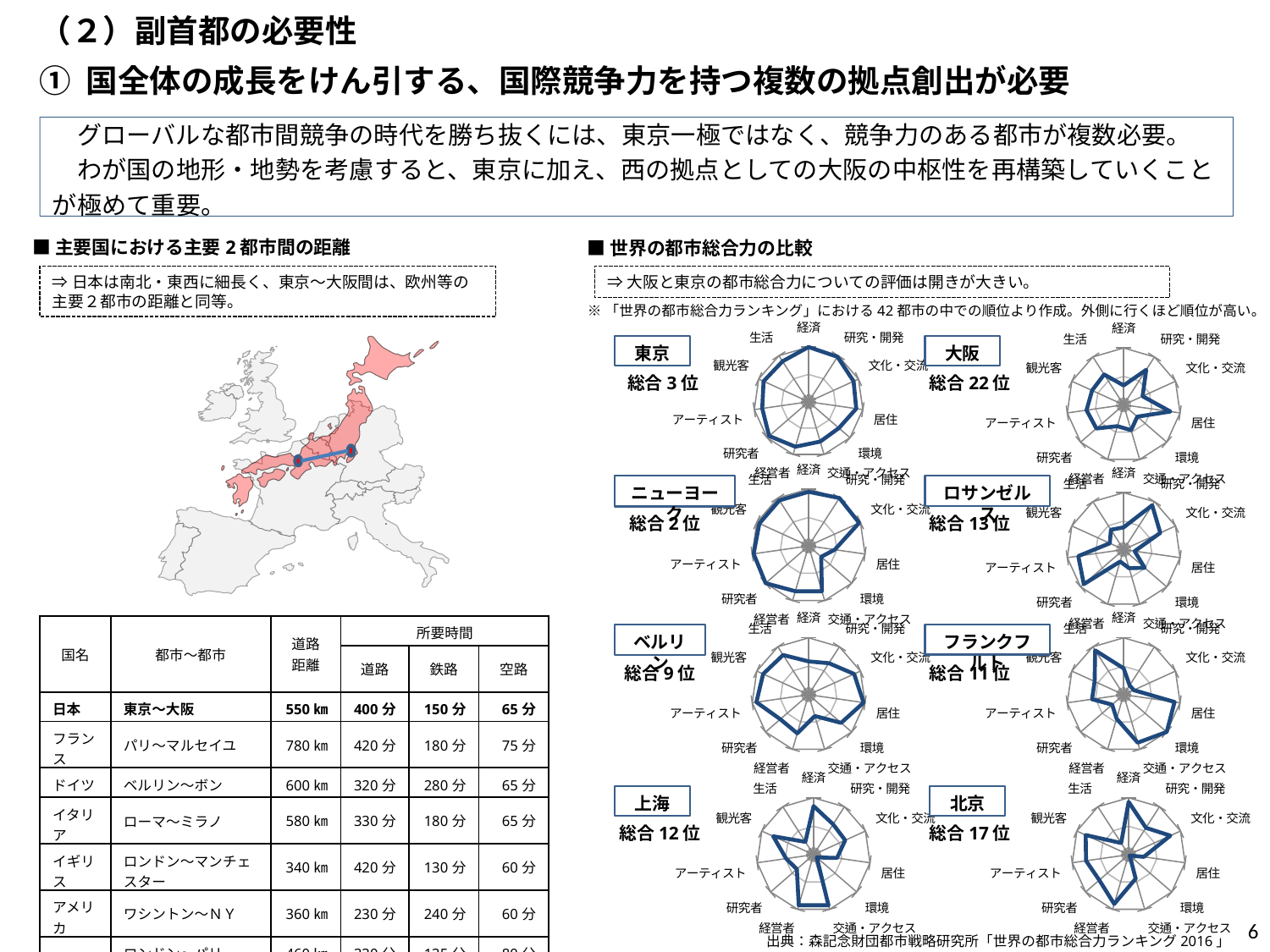
In the 「世界の都市総合力の比較」 section, what overall rank (総合) is shown for 上海? 総合12位 What source is cited for the radar charts in the 「世界の都市総合力の比較」 section? 森記念財団都市戦略研究所「世界の都市総合力ランキング 2016」 Comparing the radar charts for 東京 and 大阪, which city's plotted shape extends further toward the outer edge overall? 東京 In the 「世界の都市総合力の比較」 section, what overall rank (総合) is shown for 東京? 総合3位 Among the eight cities in the 「世界の都市総合力の比較」 section, which has the worst (lowest) overall rank? 大阪 What type of chart is used in the 「世界の都市総合力の比較」 section to show each city's profile? Radar chart In the 「世界の都市総合力の比較」 section, what overall rank (総合) is shown for ベルリン? 総合9位 In the 「世界の都市総合力の比較」 section, what overall rank (総合) is shown for 大阪? 総合22位 Among the eight cities in the 「世界の都市総合力の比較」 section, which has the best (highest) overall rank? ニューヨーク In the 「世界の都市総合力の比較」 section, what overall rank (総合) is shown for ニューヨーク? 総合2位 In the 「世界の都市総合力の比較」 section, what overall rank (総合) is shown for ロサンゼルス? 総合13位 How many radar charts are shown in the 「世界の都市総合力の比較」 section? 8